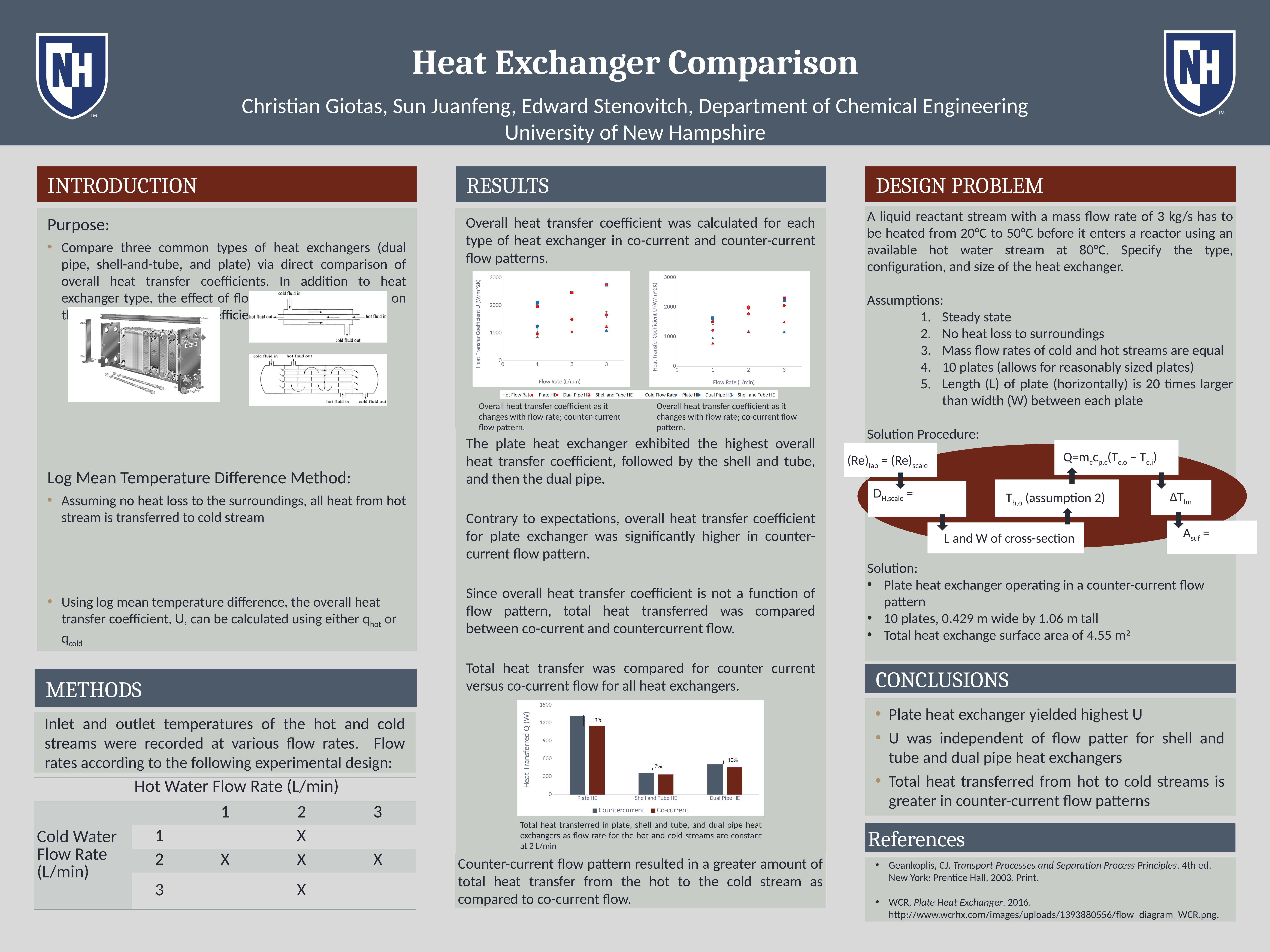
In the left scatter chart of overall heat transfer coefficient (counter-current flow pattern), what is the x-axis label? Flow Rate (L/min) What kind of chart is the 'Heat Transferred Q (W)' chart at the bottom of the Results section? bar chart In the bottom bar chart of total heat transferred, how many series does the legend list? 2 In the bottom bar chart of total heat transferred, is the Countercurrent value for Plate HE greater or less than 1200? greater In the bottom bar chart of total heat transferred, what percentage label is shown above the Dual Pipe HE bars? 10% In the bottom bar chart of total heat transferred, which is larger for Plate HE: the Countercurrent bar or the Co-current bar? Countercurrent In the bottom bar chart of total heat transferred, what percentage label is shown above the Plate HE bars? 13% In the bottom bar chart of total heat transferred, how many heat exchanger categories are shown on the x axis? 3 In the bottom bar chart of total heat transferred, which heat exchanger has the highest heat transferred? Plate HE In the bottom bar chart of total heat transferred, which heat exchanger has the lowest heat transferred? Shell and Tube HE In the bottom bar chart of total heat transferred, is the Countercurrent value for Shell and Tube HE greater or less than 600? less In the bottom bar chart of total heat transferred, which has the larger Countercurrent value: Dual Pipe HE or Shell and Tube HE? Dual Pipe HE